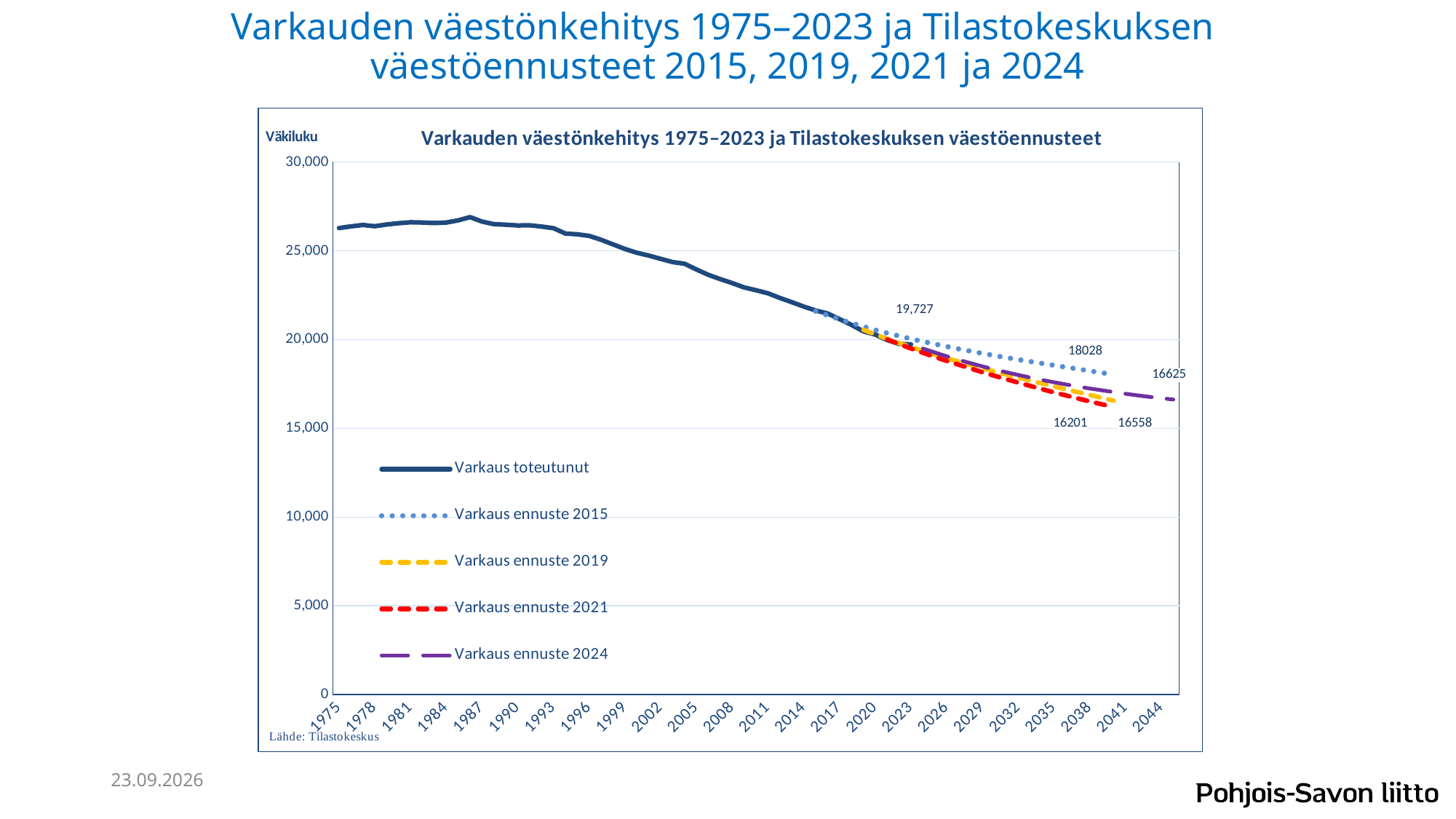
Which forecast series ends at the lowest labelled value? Varkaus ennuste 2021 What is the labelled end value of the 'Varkaus ennuste 2024' series? 16625 What is the labelled end value of the 'Varkaus ennuste 2021' series? 16201 How many series does the legend list? 5 What is the labelled end value of the 'Varkaus ennuste 2015' series? 18028 What is the label on the vertical axis of the chart? Väkiluku What is the labelled end value of the 'Varkaus ennuste 2019' series? 16558 Which ends higher: 'Varkaus ennuste 2015' or 'Varkaus ennuste 2021'? Varkaus ennuste 2015 What kind of chart is shown on the slide? line chart Does the 'Varkaus toteutunut' series rise or fall from 1990 to 2023? fall Is the value of 'Varkaus toteutunut' in 1975 greater or less than 25,000? greater What is the difference between the labelled end values of 'Varkaus ennuste 2015' (18028) and 'Varkaus ennuste 2021' (16201)? 1827